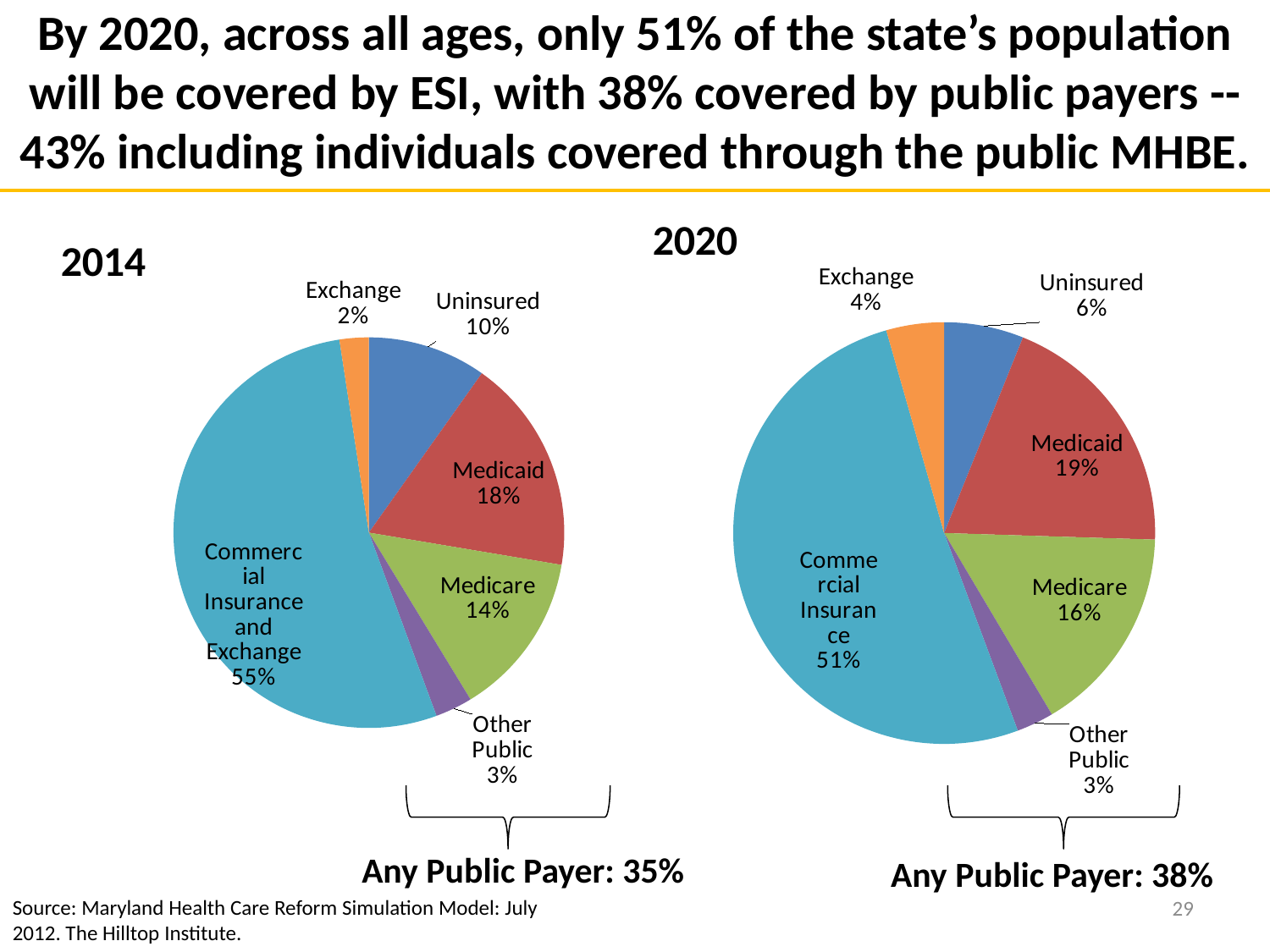
In the 2014 pie chart, which category has the largest slice? Commercial Insurance and Exchange In the 2014 pie chart, which category has the smallest slice? Exchange In the 2020 pie chart, what share is Uninsured? 6% In the 2014 pie chart, what share is Medicaid? 18% In the 2020 pie chart, what share is Commercial Insurance? 51% How many categories does the 2020 pie chart show? 6 What type of chart is used for the 2014 data? Pie chart What is the difference between the Medicare share in 2020 and in 2014? 2% In the 2020 pie chart, which is larger, Medicaid or Medicare? Medicaid What is the Any Public Payer share shown below the 2020 pie chart? 38% In the 2020 pie chart, which category has the largest slice? Commercial Insurance In the 2014 pie chart, what share is Exchange? 2%